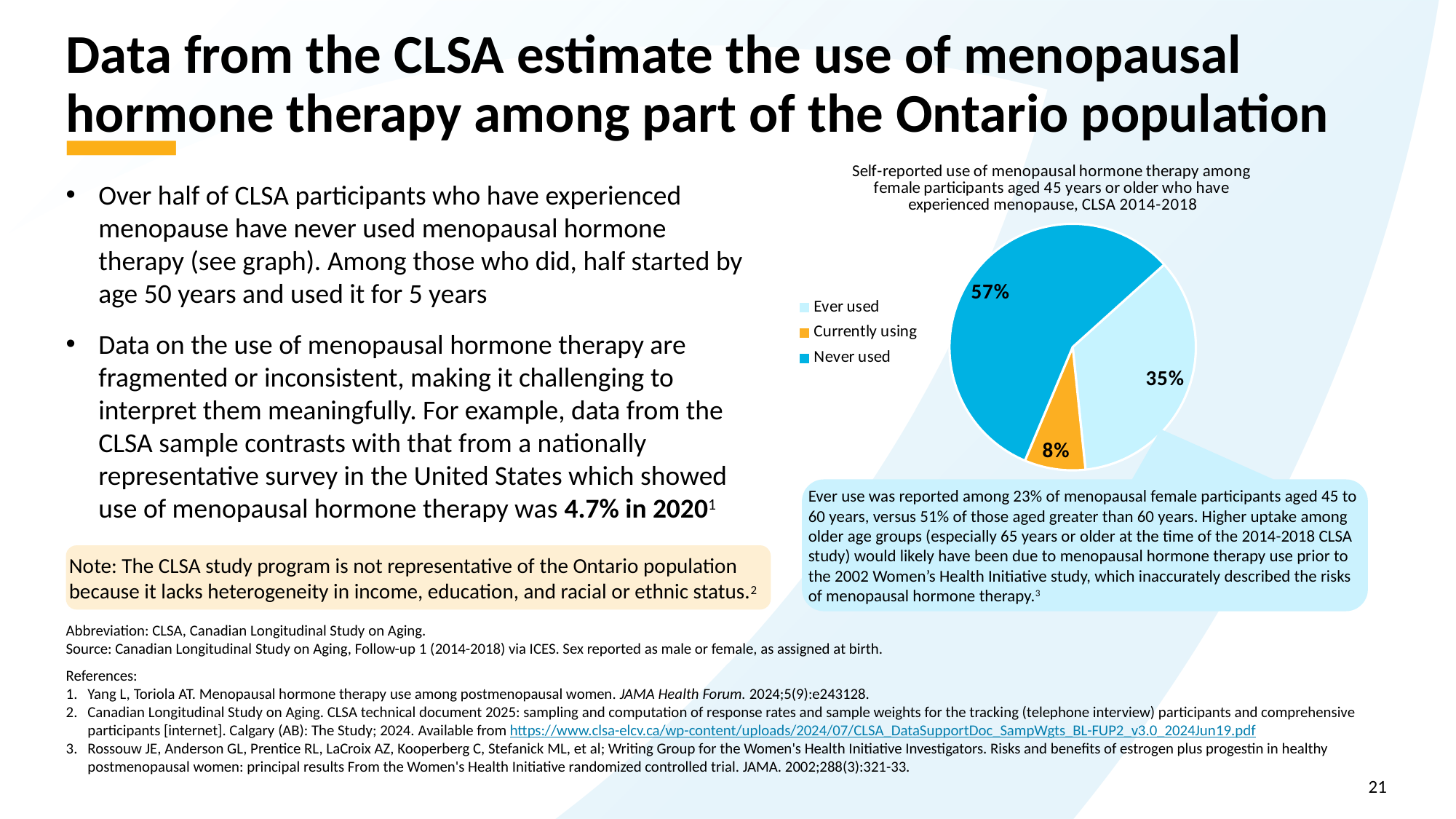
What percentage of participants never used menopausal hormone therapy? 57% Which is larger, the share for 'Ever used' or the share for 'Currently using'? Ever used What percentage of participants are currently using menopausal hormone therapy? 8% How many categories does the pie chart show? 3 Which category has the largest share of the pie? Never used What years does the chart title say the CLSA data cover? 2014-2018 Which category has the smallest share of the pie? Currently using What is the difference in percentage points between 'Never used' and 'Ever used'? 22 How many entries does the legend list? 3 What kind of chart is shown on the slide? Pie chart What percentage of participants have ever used menopausal hormone therapy? 35% What colour represents 'Currently using' in the pie chart? Orange